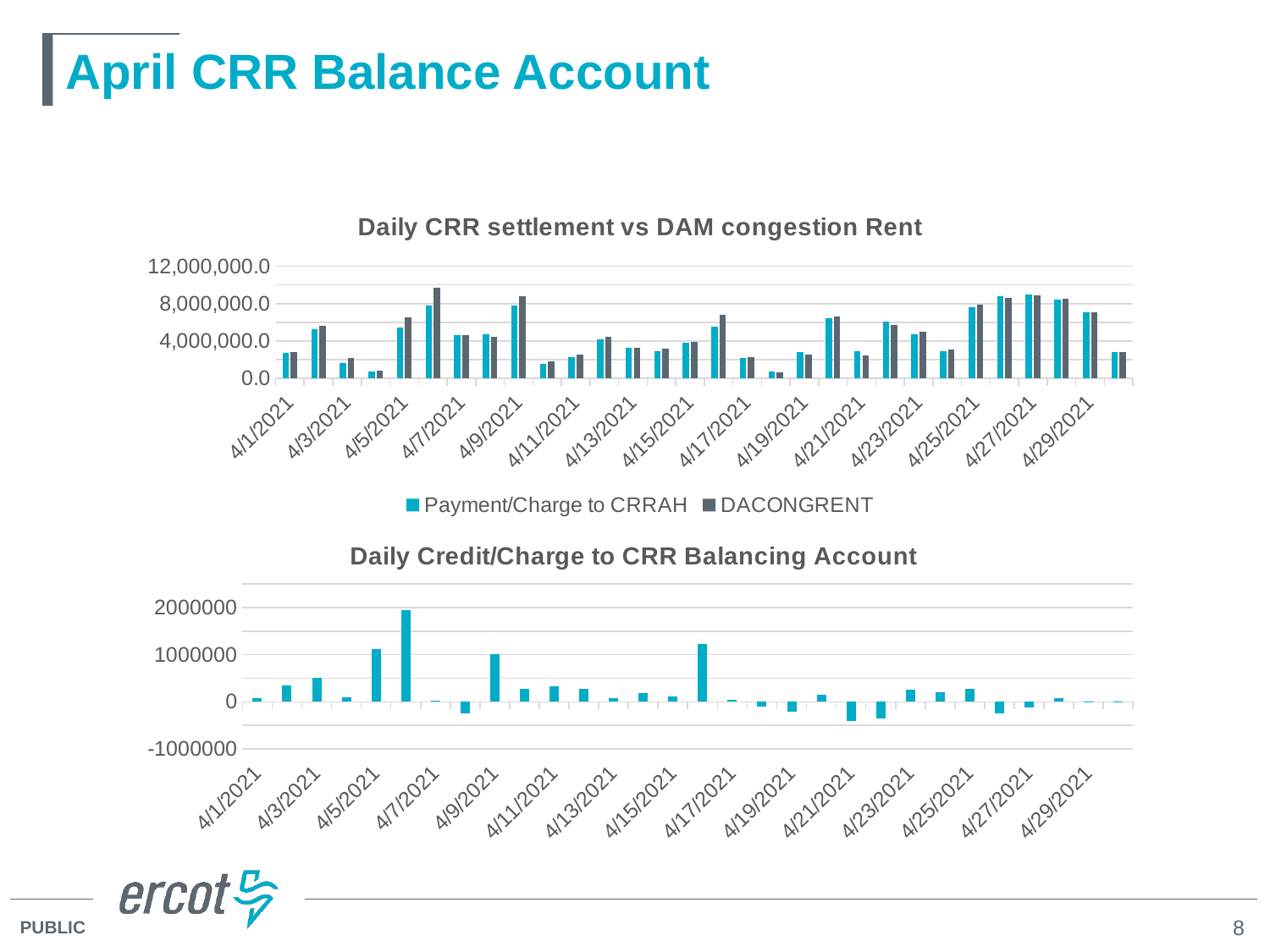
In the top chart 'Daily CRR settlement vs DAM congestion Rent', which series has the larger value on 4/6/2021, Payment/Charge to CRRAH or DACONGRENT? DACONGRENT In the top chart 'Daily CRR settlement vs DAM congestion Rent', is the DACONGRENT value for 4/6/2021 greater or less than 8,000,000.0? greater In the top chart 'Daily CRR settlement vs DAM congestion Rent', what are the two series named in the legend? Payment/Charge to CRRAH and DACONGRENT In the top chart 'Daily CRR settlement vs DAM congestion Rent', on which date does the DACONGRENT series reach its highest value? 4/6/2021 In the bottom chart 'Daily Credit/Charge to CRR Balancing Account', which date has the larger value, 4/5/2021 or 4/6/2021? 4/6/2021 What is the title of the bottom chart on the slide? Daily Credit/Charge to CRR Balancing Account In the bottom chart 'Daily Credit/Charge to CRR Balancing Account', is the value for 4/21/2021 greater or less than 0? less How many series does the legend of the top chart 'Daily CRR settlement vs DAM congestion Rent' list? 2 In the bottom chart 'Daily Credit/Charge to CRR Balancing Account', is the value for 4/17/2021 greater or less than 1000000? less In the bottom chart 'Daily Credit/Charge to CRR Balancing Account', on which date is the value highest? 4/6/2021 What kind of chart is the top chart titled 'Daily CRR settlement vs DAM congestion Rent'? Bar chart